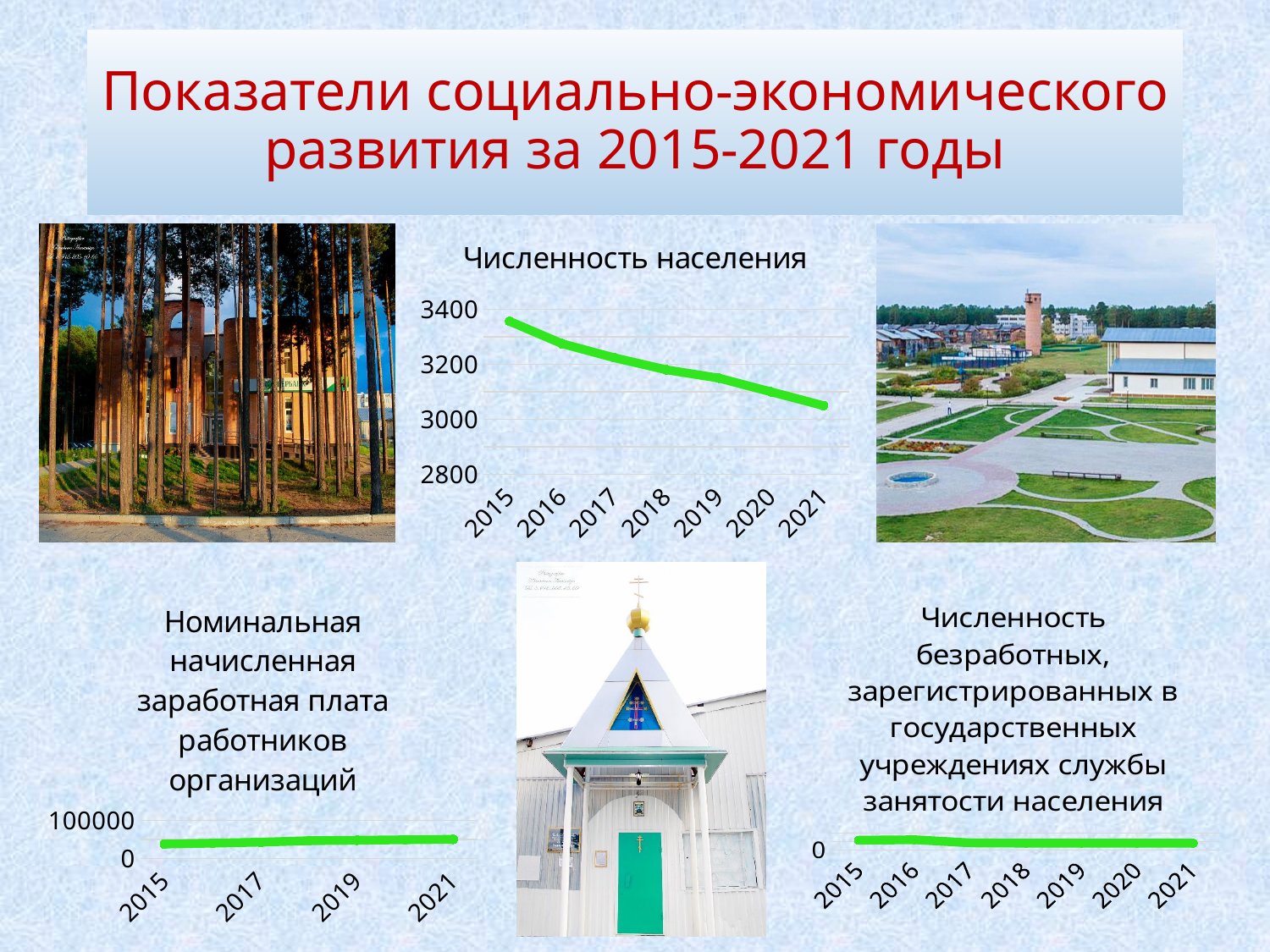
How many years are plotted on the x axis of the "Численность населения" chart? 7 In the "Численность населения" chart, which year has the lowest value? 2021 In the "Численность населения" chart, is the value for 2015 greater or less than 3200? greater How many years are labelled on the x axis of the "Численность безработных" chart (bottom right)? 7 In the "Численность населения" chart, is the value for 2021 greater or less than 3200? less In the "Численность населения" chart, is the value for 2020 greater or less than 3200? less What kind of chart is the "Номинальная начисленная заработная плата работников организаций" chart? line chart In the "Численность населения" chart, which year has the highest value? 2015 What kind of chart is the "Численность населения" chart? line chart In the "Численность населения" chart, do the values rise or fall from 2015 to 2021? fall